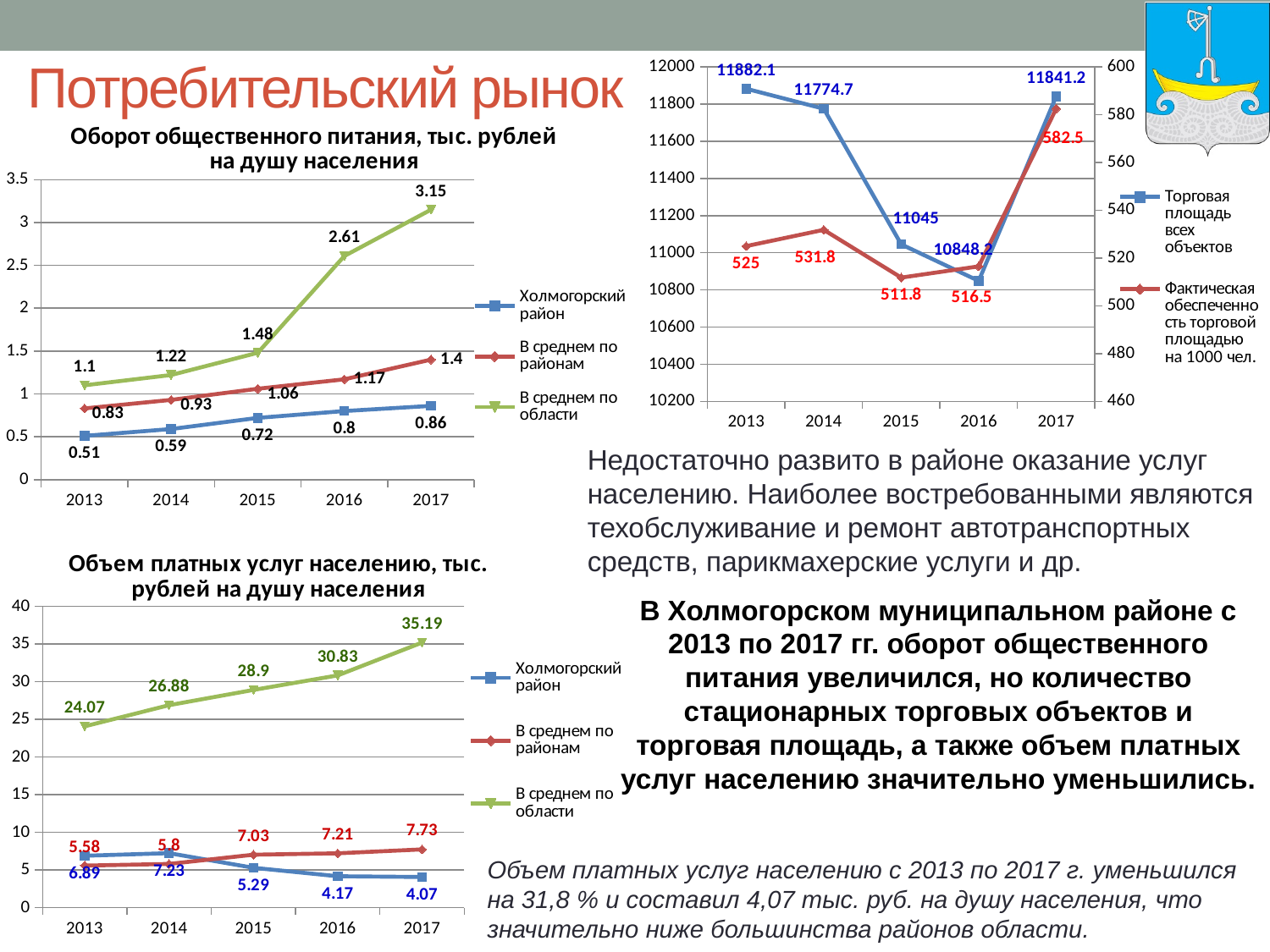
On the top-right chart, what is the value for 'Фактическая обеспеченность торговой площадью на 1000 чел.' in 2017? 582.5 On the chart 'Объем платных услуг населению, тыс. рублей на душу населения', how many years are shown on the x axis? 5 On the chart 'Объем платных услуг населению, тыс. рублей на душу населения', which is larger in 2016: 'В среднем по районам' or 'Холмогорский район'? В среднем по районам On the chart 'Оборот общественного питания, тыс. рублей на душу населения', what is the value for 'Холмогорский район' in 2013? 0.51 On the chart 'Объем платных услуг населению, тыс. рублей на душу населения', what is the value for 'Холмогорский район' in 2017? 4.07 On the chart 'Оборот общественного питания, тыс. рублей на душу населения', does the value for 'В среднем по области' rise or fall from 2013 to 2017? rise On the chart 'Оборот общественного питания, тыс. рублей на душу населения', how many series does the legend list? 3 On the chart 'Оборот общественного питания, тыс. рублей на душу населения', what is the difference between 'В среднем по области' and 'Холмогорский район' in 2017? 2.29 On the top-right chart, what is the value for 'Торговая площадь всех объектов' in 2015? 11045 On the top-right chart, in which year is 'Торговая площадь всех объектов' lowest? 2016 On the chart 'Оборот общественного питания, тыс. рублей на душу населения', what is the value for 'В среднем по области' in 2017? 3.15 On the top-right chart, what kind of chart is it? line chart